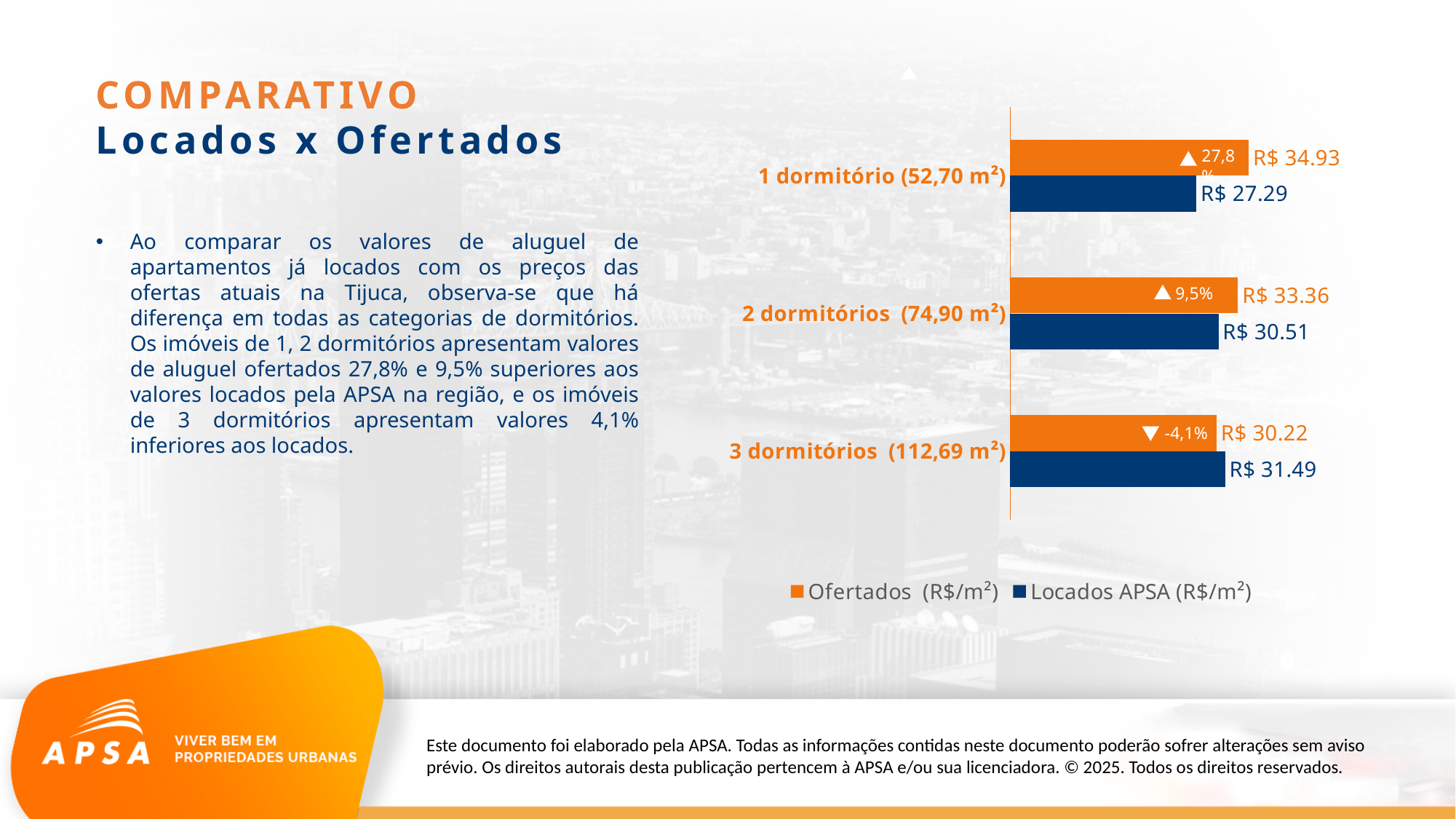
What is the difference between the Locados APSA and Ofertados values for 3 dormitórios (112,69 m²)? R$ 1.27 What is the Locados APSA (R$/m²) value for 3 dormitórios (112,69 m²)? R$ 31.49 What kind of chart is shown on the slide? Bar chart What is the Ofertados (R$/m²) value for 1 dormitório (52,70 m²)? R$ 34.93 What is the Locados APSA (R$/m²) value for 2 dormitórios (74,90 m²)? R$ 30.51 Which category has the lowest Locados APSA (R$/m²) value? 1 dormitório (52,70 m²) How many series does the chart legend list? 2 What is the Ofertados (R$/m²) value for 3 dormitórios (112,69 m²)? R$ 30.22 How many dormitório categories are shown in the chart? 3 What is the difference between the Ofertados and Locados APSA values for 1 dormitório (52,70 m²)? R$ 7.64 Which category has the highest Ofertados (R$/m²) value? 1 dormitório (52,70 m²) For 3 dormitórios (112,69 m²), which is larger: the Ofertados value or the Locados APSA value? Locados APSA